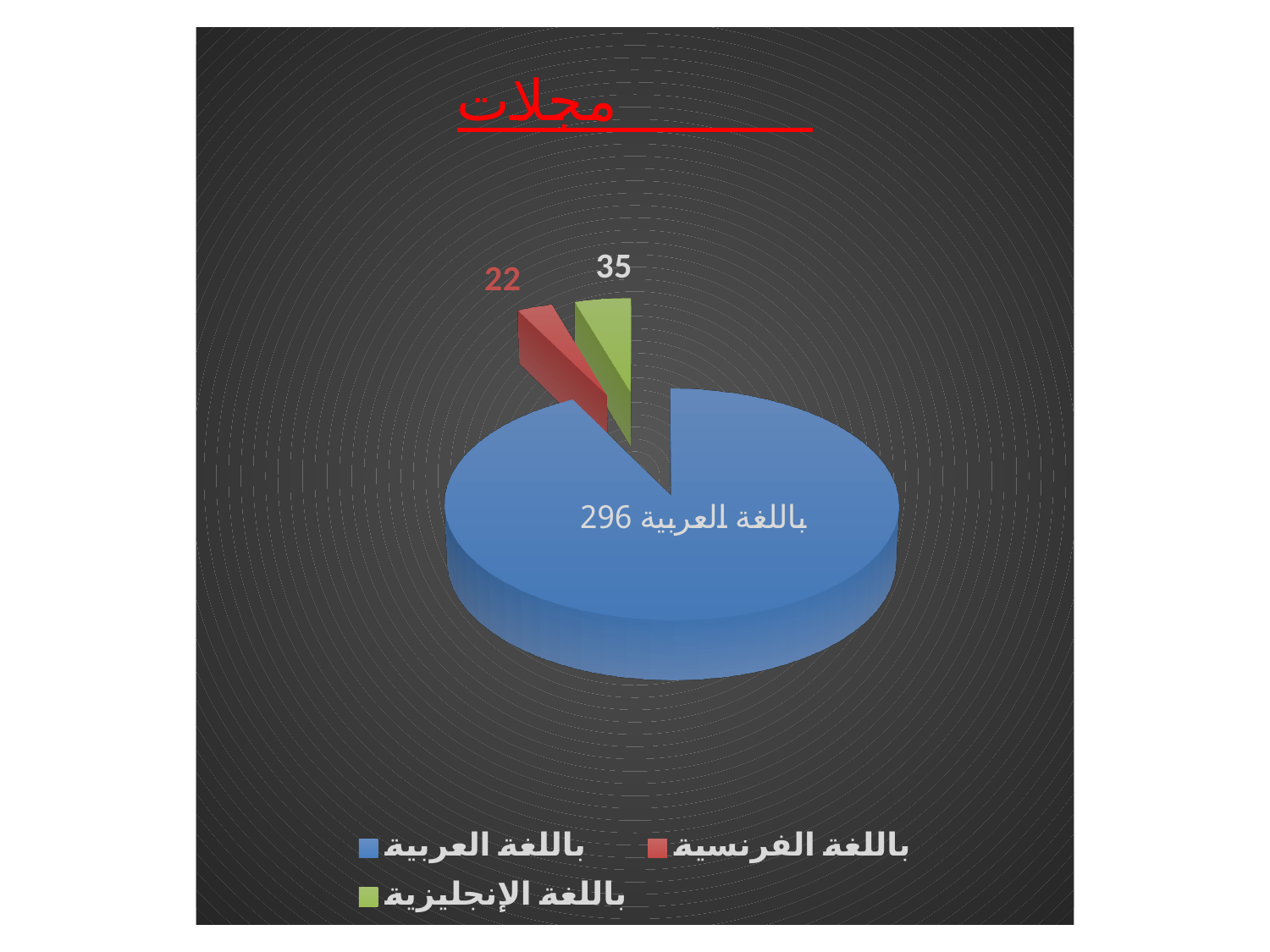
What is the difference between the values for باللغة الإنجليزية and باللغة الفرنسية? 13 What is the value for باللغة الإنجليزية in the pie chart? 35 What kind of chart is shown on the slide? Pie chart What is the value for باللغة الفرنسية in the pie chart? 22 Which category has the smallest slice in the pie chart? باللغة الفرنسية What is the title of the chart? مجلات Which is larger, the value for باللغة الإنجليزية or the value for باللغة الفرنسية? باللغة الإنجليزية What colour is the slice for باللغة الفرنسية? Red Which category has the largest slice in the pie chart? باللغة العربية How many categories are shown in the pie chart? 3 What is the value for باللغة العربية in the pie chart? 296 What is the difference between the values for باللغة العربية and باللغة الإنجليزية? 261